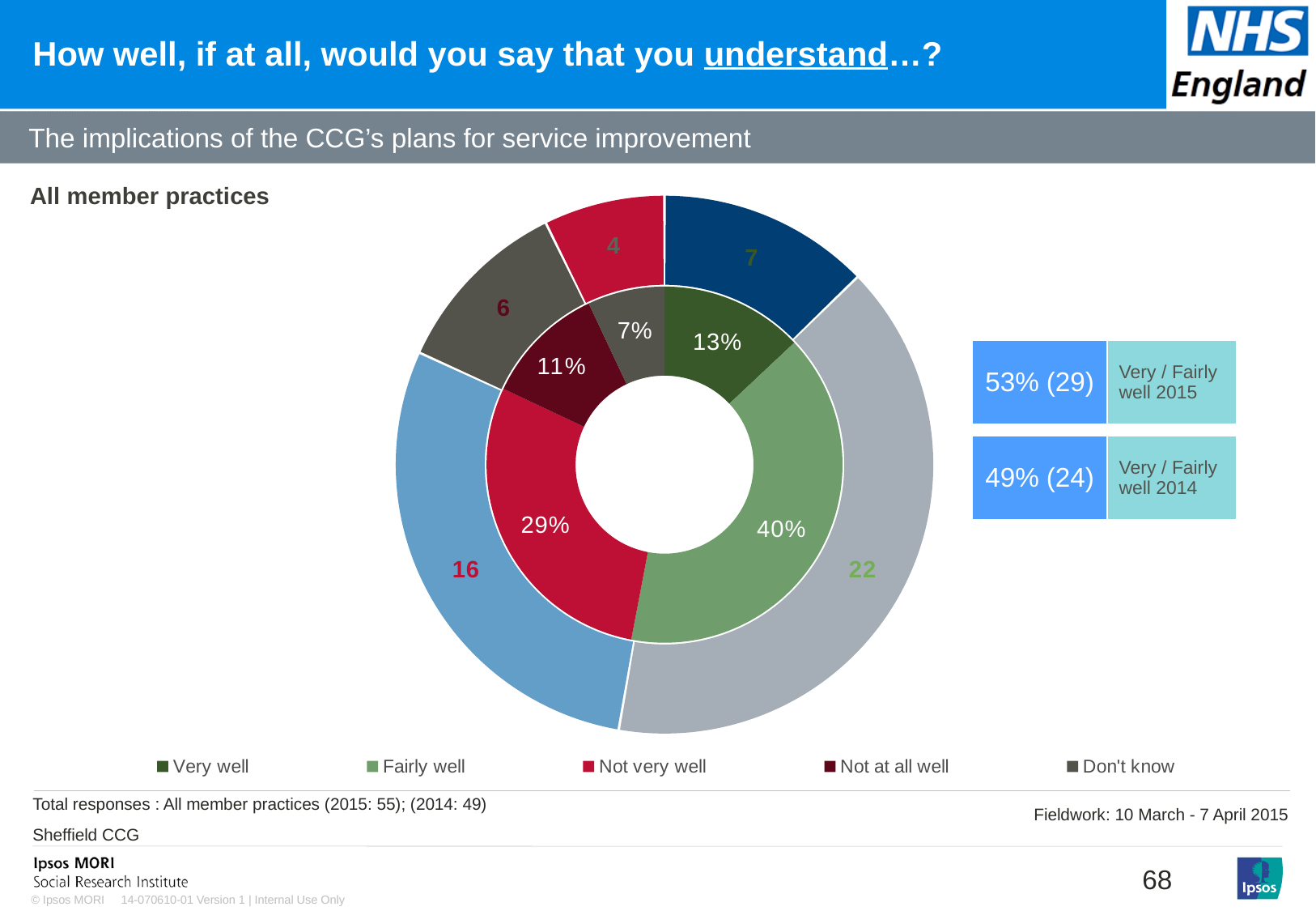
What percentage of respondents said they understand the implications of the CCG's plans for service improvement 'Fairly well'? 40% How many response categories does the legend list? 5 What type of chart is shown on the slide? Doughnut chart What is the combined 'Very / Fairly well' figure for 2014 shown in the box beside the chart? 49% (24) What percentage of respondents answered 'Very well'? 13% What is the difference in percentage points between 'Fairly well' and 'Not very well'? 11 percentage points What percentage of respondents answered 'Don't know'? 7% Which is larger, the share for 'Not at all well' or the share for 'Very well'? Very well What percentage of respondents answered 'Not very well'? 29% Which response category has the smallest share in the inner ring of the doughnut chart? Don't know What is the combined 'Very / Fairly well' figure for 2015 shown in the box beside the chart? 53% (29) Which response category has the largest share in the inner ring of the doughnut chart? Fairly well